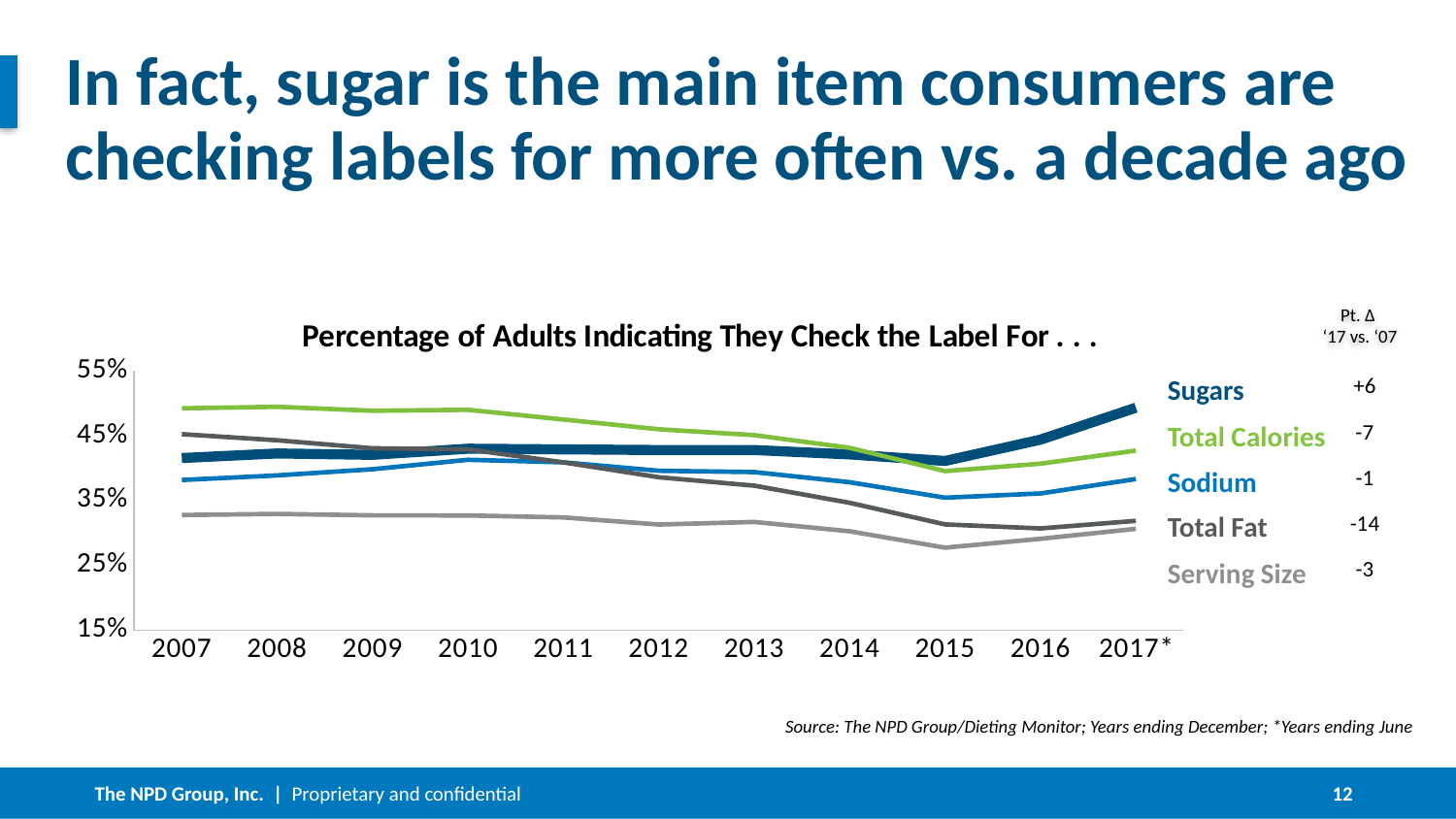
How many years are shown on the x axis of the chart? 11 What is the point change ('17 vs. '07) shown for Total Fat? -14 Does the Total Fat line rise or fall from 2007 to 2017*? fall Which series has the highest value in 2017*? Sugars Which series has the lowest value in 2017*? Serving Size Is the value for Sugars in 2017* greater or less than 45%? greater Is the value for Total Fat in 2015 greater or less than 35%? less What kind of chart is shown on the slide? line chart What is the point change ('17 vs. '07) shown for Sugars? +6 How many series does the chart show? 5 Which series shows the largest decline in the Pt. Δ '17 vs. '07 column? Total Fat What is the point change ('17 vs. '07) shown for Total Calories? -7